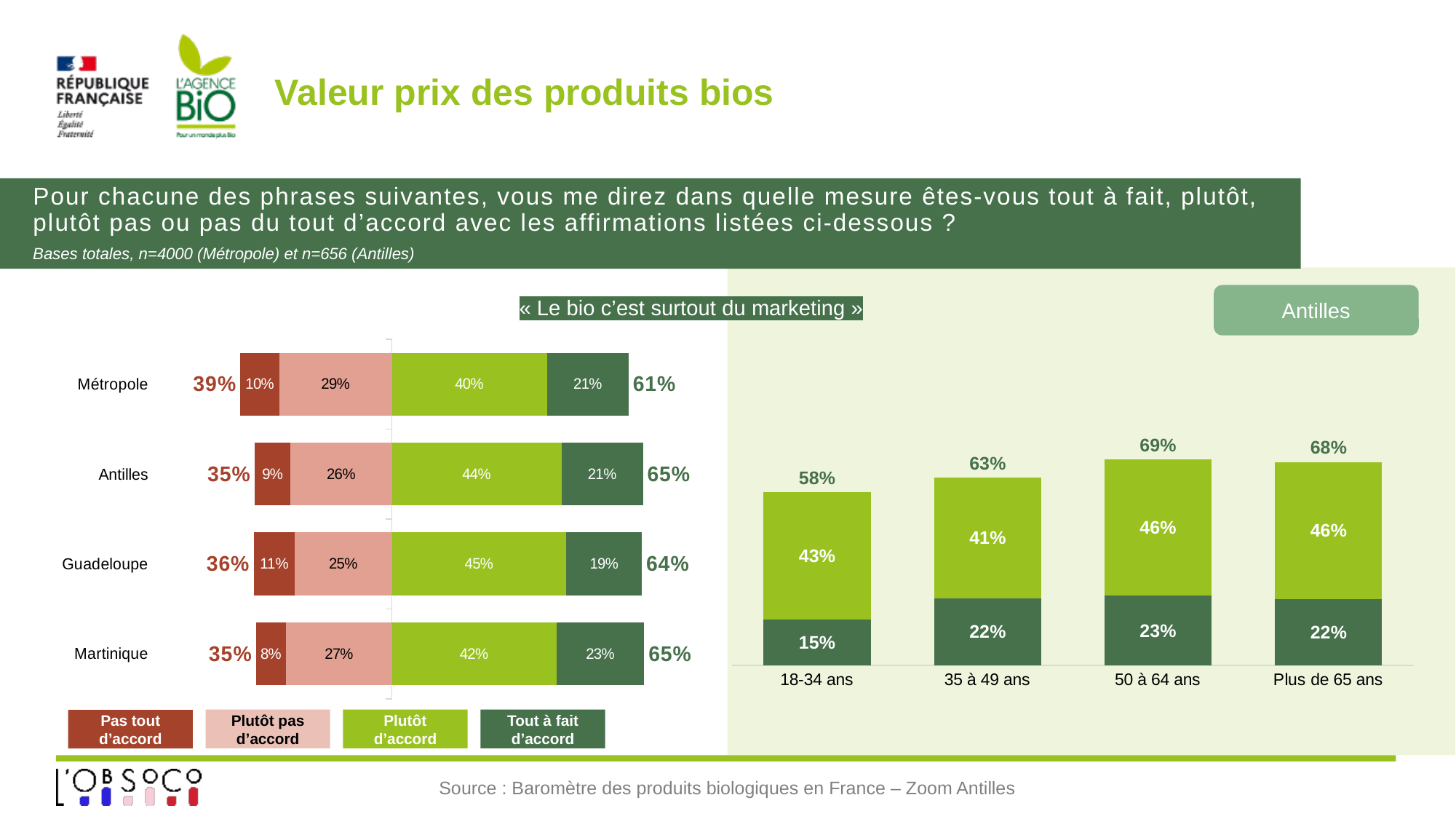
In the right chart (Antilles by age group), is the "Plutôt d'accord" value larger for 18-34 ans or for 50 à 64 ans? 50 à 64 ans In the right chart (Antilles by age group), what is the "Tout à fait d'accord" value for 18-34 ans? 15% In the left chart, which region has the highest combined disagreement total (left-hand bold figure)? Métropole In the right chart (Antilles by age group), which age group has the highest total? 50 à 64 ans In the right chart (Antilles by age group), what is the total for 35 à 49 ans? 63% In the left chart, how many regions are shown? 4 In the left chart (« Le bio c'est surtout du marketing »), what percentage of Métropole respondents answered "Plutôt d'accord"? 40% What type of chart is the right chart (Antilles by age group)? Stacked bar chart In the left chart, what is the combined agreement total (right-hand bold figure) for Martinique? 65% In the left chart, what is the "Pas tout d'accord" value for Guadeloupe? 11% In the left chart, what is the difference between the "Tout à fait d'accord" values for Martinique and Guadeloupe? 4% In the left chart, how many series does the legend list? 4